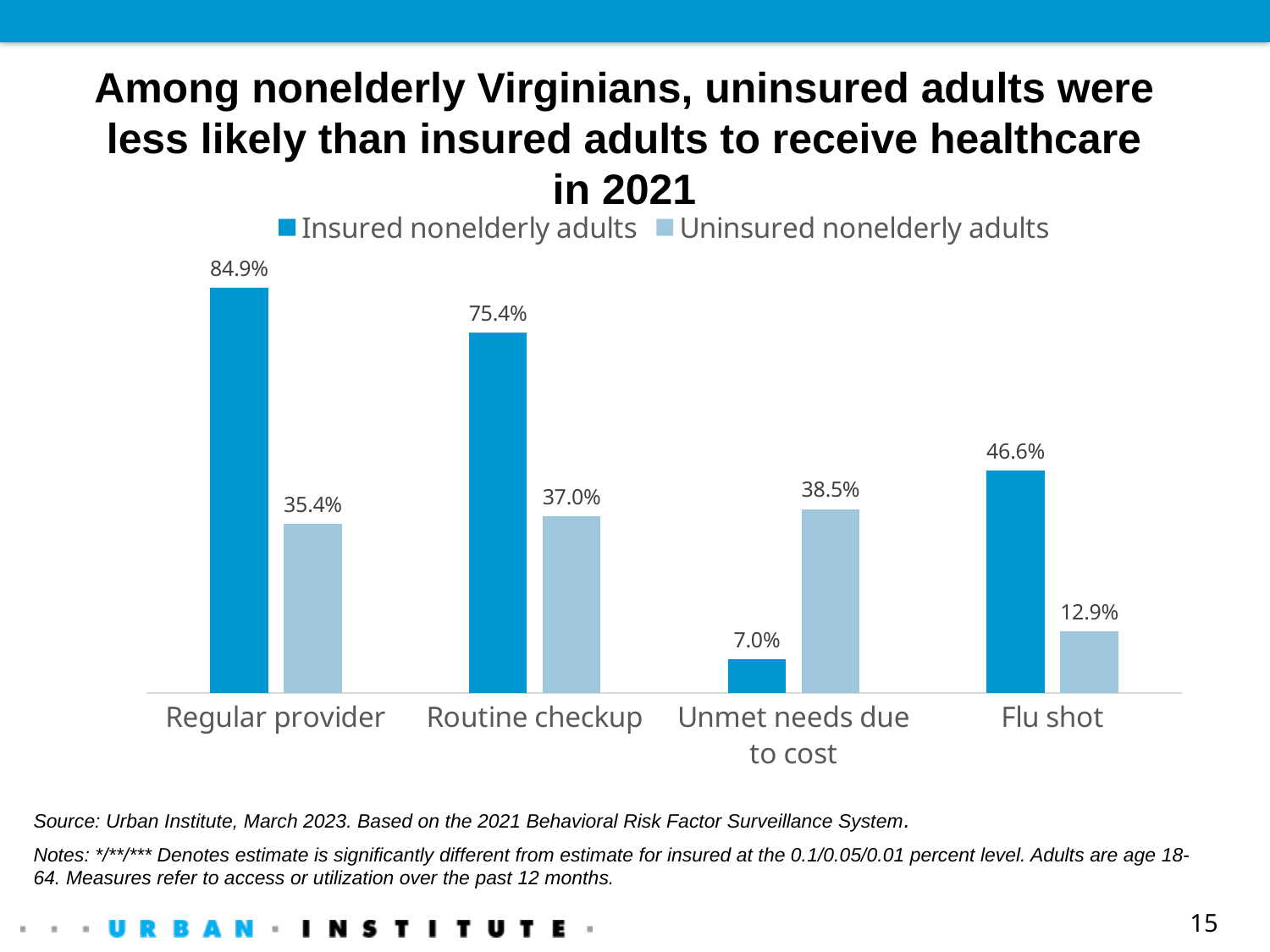
What kind of chart is shown on the slide? Bar chart In the Unmet needs due to cost category, which series has the larger value? Uninsured nonelderly adults How many series does the legend list? 2 What is the difference between Insured and Uninsured nonelderly adults in the Routine checkup category? 38.4% Which category has the highest value for Insured nonelderly adults? Regular provider What is the value for Uninsured nonelderly adults in the Flu shot category? 12.9% How many categories are shown on the x axis? 4 What is the difference between Insured and Uninsured nonelderly adults in the Flu shot category? 33.7% Which series is shown in the darker blue colour? Insured nonelderly adults Which category has the lowest value for Uninsured nonelderly adults? Flu shot What is the value for Insured nonelderly adults in the Unmet needs due to cost category? 7.0% What is the value for Insured nonelderly adults in the Regular provider category? 84.9%